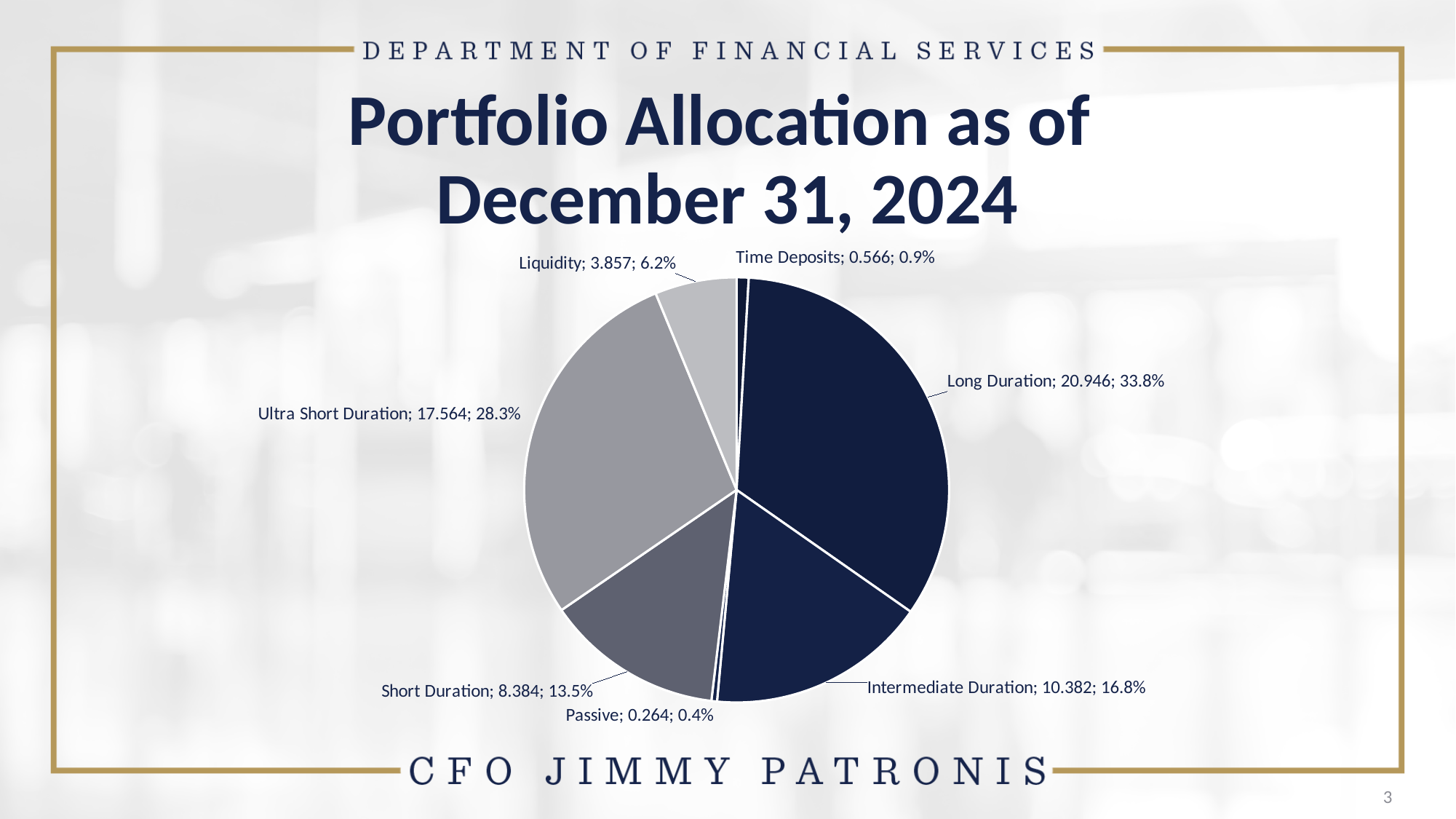
Which category has the largest slice? Long Duration How many slices does the pie chart have? 7 What is the value shown for Intermediate Duration? 10.382 What is the difference between the values for Long Duration and Ultra Short Duration? 3.382 What is the title of the slide containing the chart? Portfolio Allocation as of December 31, 2024 What is the value shown for Long Duration? 20.946 Which is larger, Short Duration or Liquidity? Short Duration What kind of chart is shown on the slide? Pie chart Which category has the smallest slice? Passive What is the value shown for Passive? 0.264 What percentage share does Ultra Short Duration have? 28.3% What percentage share does Time Deposits have? 0.9%